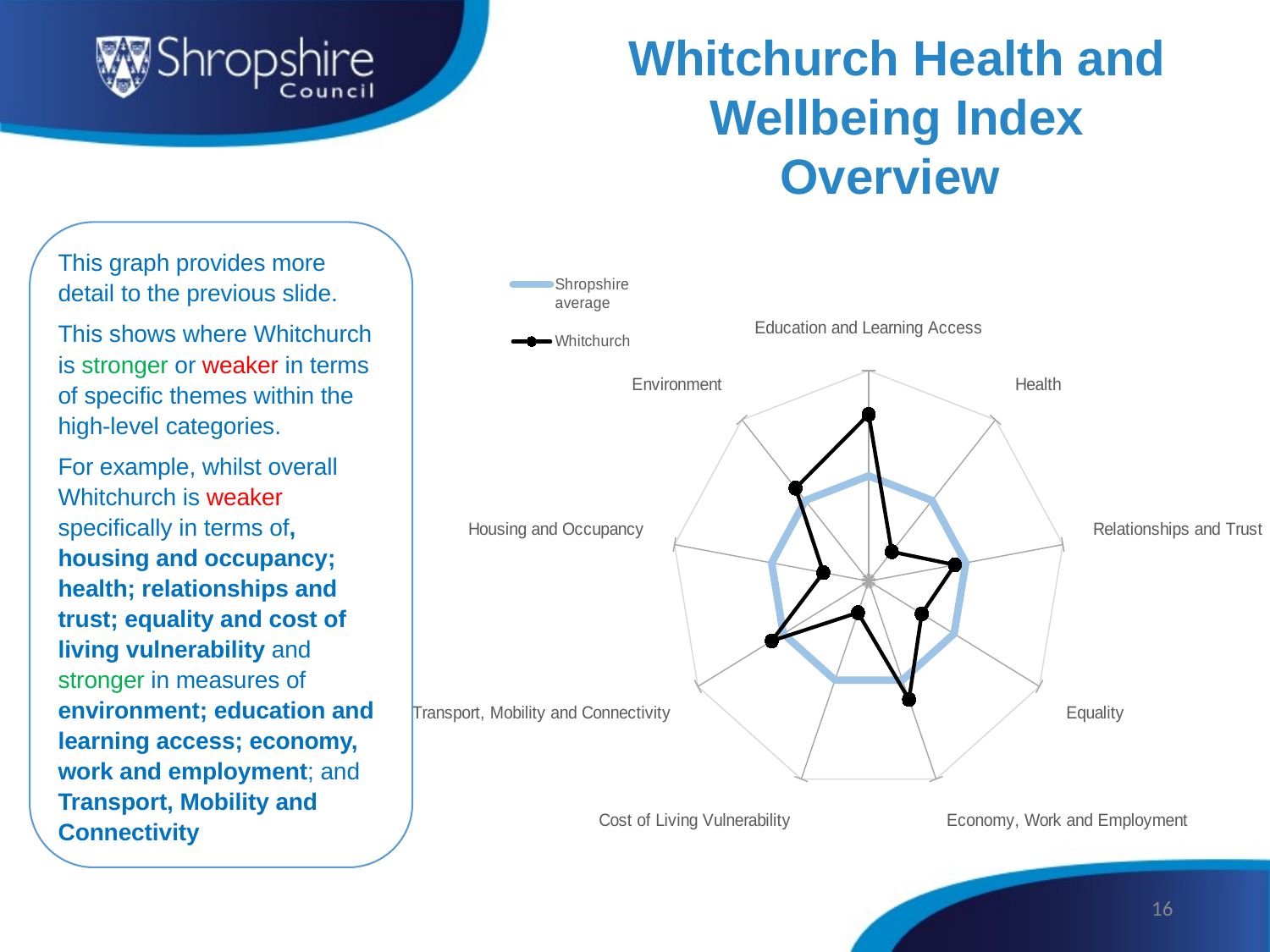
For Environment, which is larger: the Whitchurch value or the Shropshire average? Whitchurch For Transport, Mobility and Connectivity, which is larger: the Whitchurch value or the Shropshire average? Whitchurch For Education and Learning Access, which is larger: the Whitchurch value or the Shropshire average? Whitchurch Which two series are listed in the chart legend? Shropshire average and Whitchurch Which series is drawn as a black line with circular markers? Whitchurch How many series does the chart legend list? 2 How many categories (axes) does the radar chart have? 9 What kind of chart is shown on the slide? Radar chart